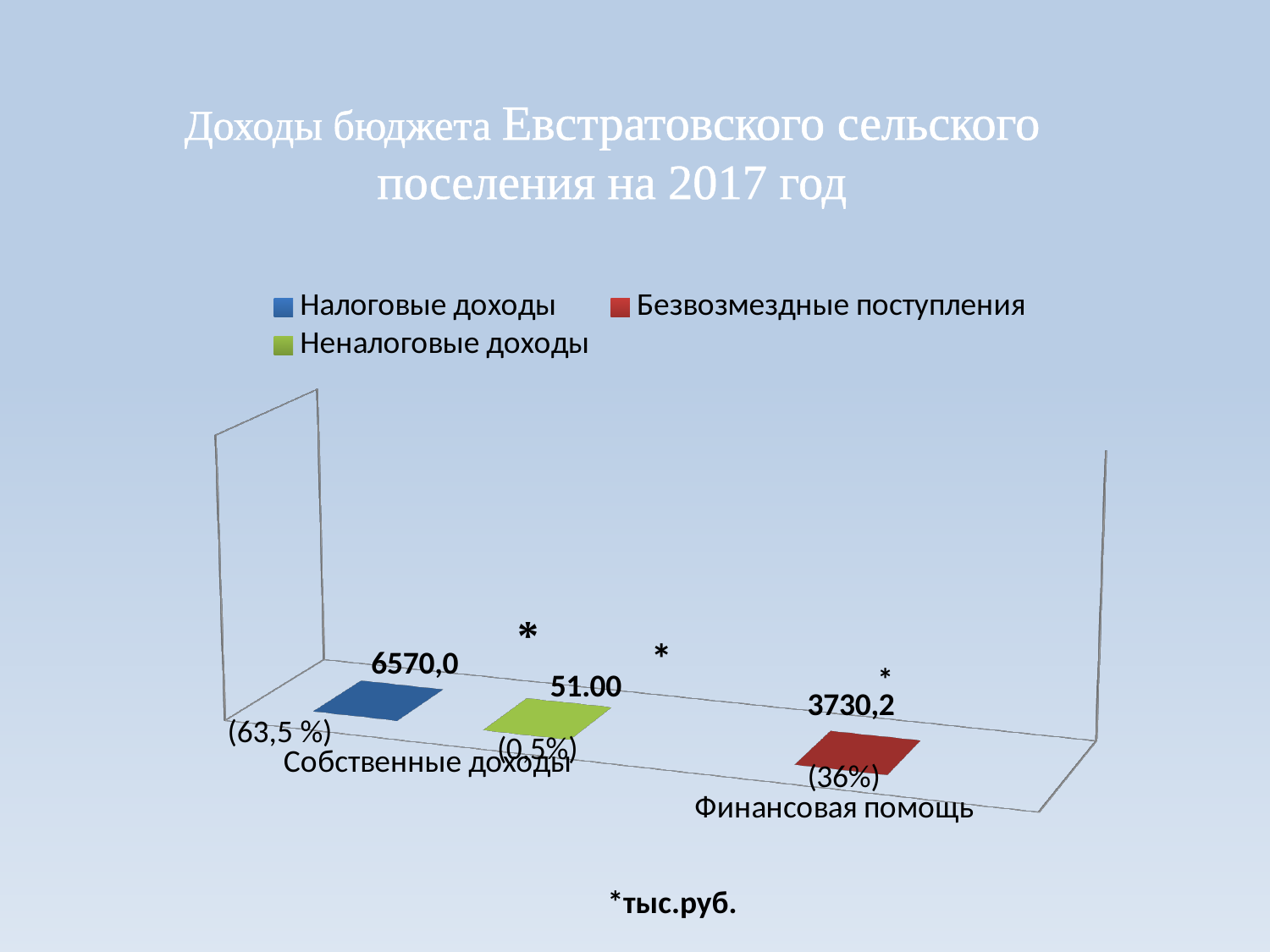
What percentage share is printed next to the Безвозмездные поступления value? 36% What percentage share is printed next to the Налоговые доходы value? 63,5 % How many categories are shown on the x axis of the chart? 2 Which is larger, the value for Налоговые доходы or the value for Безвозмездные поступления? Налоговые доходы What value is shown for Неналоговые доходы on the chart? 51.00 Which series has the lowest value on the chart? Неналоговые доходы What unit is indicated by the asterisk note below the chart? тыс.руб. What value is shown for Безвозмездные поступления on the chart? 3730,2 What is the difference between the Налоговые доходы value and the Безвозмездные поступления value? 2839,8 What value is shown for Налоговые доходы on the chart? 6570,0 Which series has the highest value on the chart? Налоговые доходы How many series does the legend list? 3